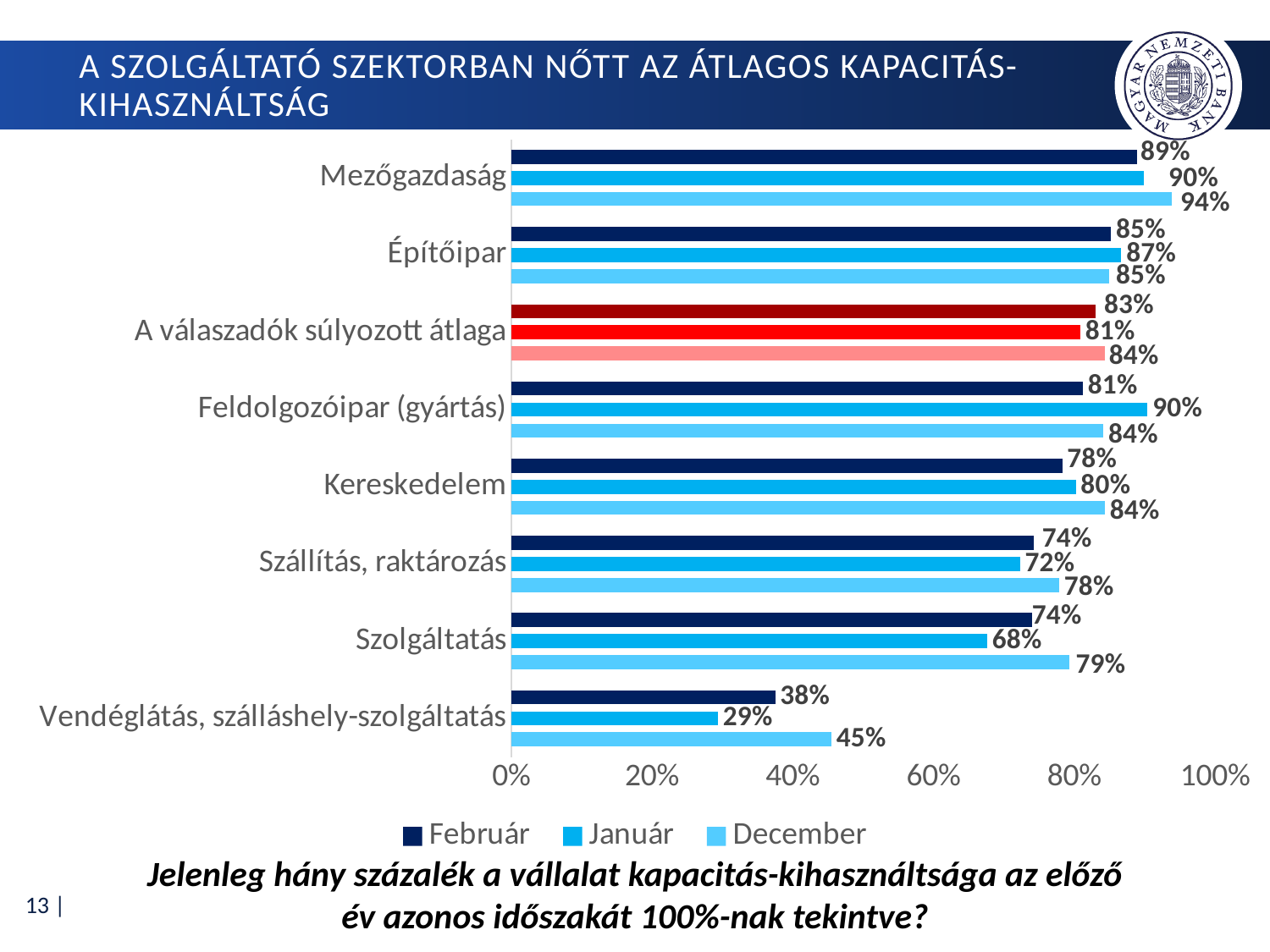
Which category has the highest Február value? Mezőgazdaság What is the Február value for Szolgáltatás? 74% How many series does the legend list? 3 What is the Január value for A válaszadók súlyozott átlaga? 81% What is the December value for Mezőgazdaság? 94% What kind of chart is shown on the slide? Bar chart What is the Január value for Vendéglátás, szálláshely-szolgáltatás? 29% What is the difference between the December and Január values for Szolgáltatás? 11% Which category has the lowest December value? Vendéglátás, szálláshely-szolgáltatás How many categories are shown on the chart? 8 Which is larger for Feldolgozóipar (gyártás): the Január value or the Február value? Január